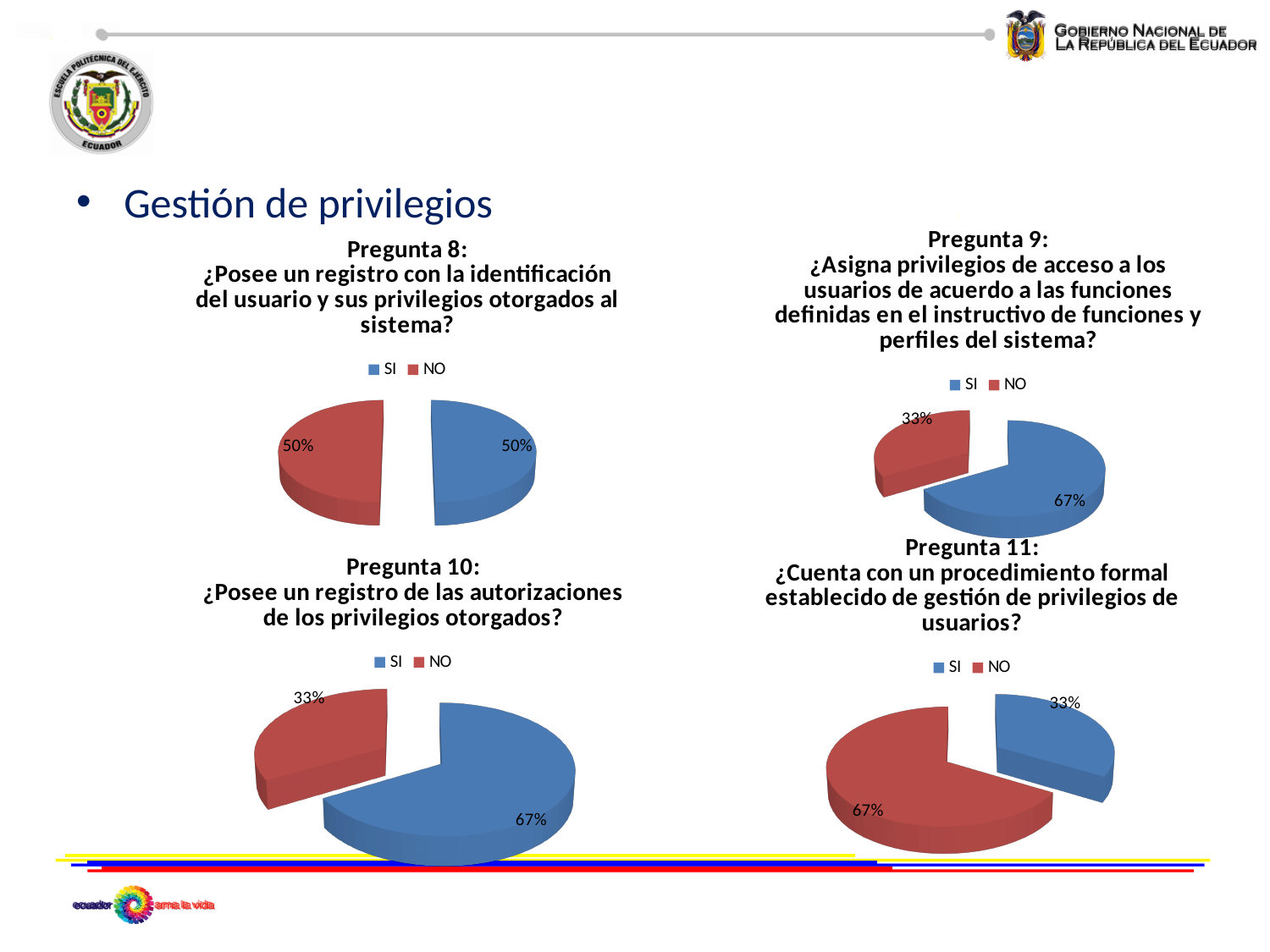
In the Pregunta 9 chart, what colour represents the SI slice? Blue In the Pregunta 10 chart, which response has the smallest share? NO What type of chart is used for Pregunta 8? Pie chart In the Pregunta 10 chart, what is the difference between the SI share and the NO share? 34% In the Pregunta 10 chart, what share of responses is SI? 67% How many series does the legend of the Pregunta 11 chart list? 2 In the Pregunta 9 chart, which response has the largest share? SI In the Pregunta 9 chart, what share of responses is NO? 33% In the Pregunta 8 chart, what share of responses is SI? 50% In the Pregunta 11 chart, what share of responses is NO? 67% In the Pregunta 11 chart, which response has the larger share, SI or NO? NO How many pie charts are shown on the slide? 4